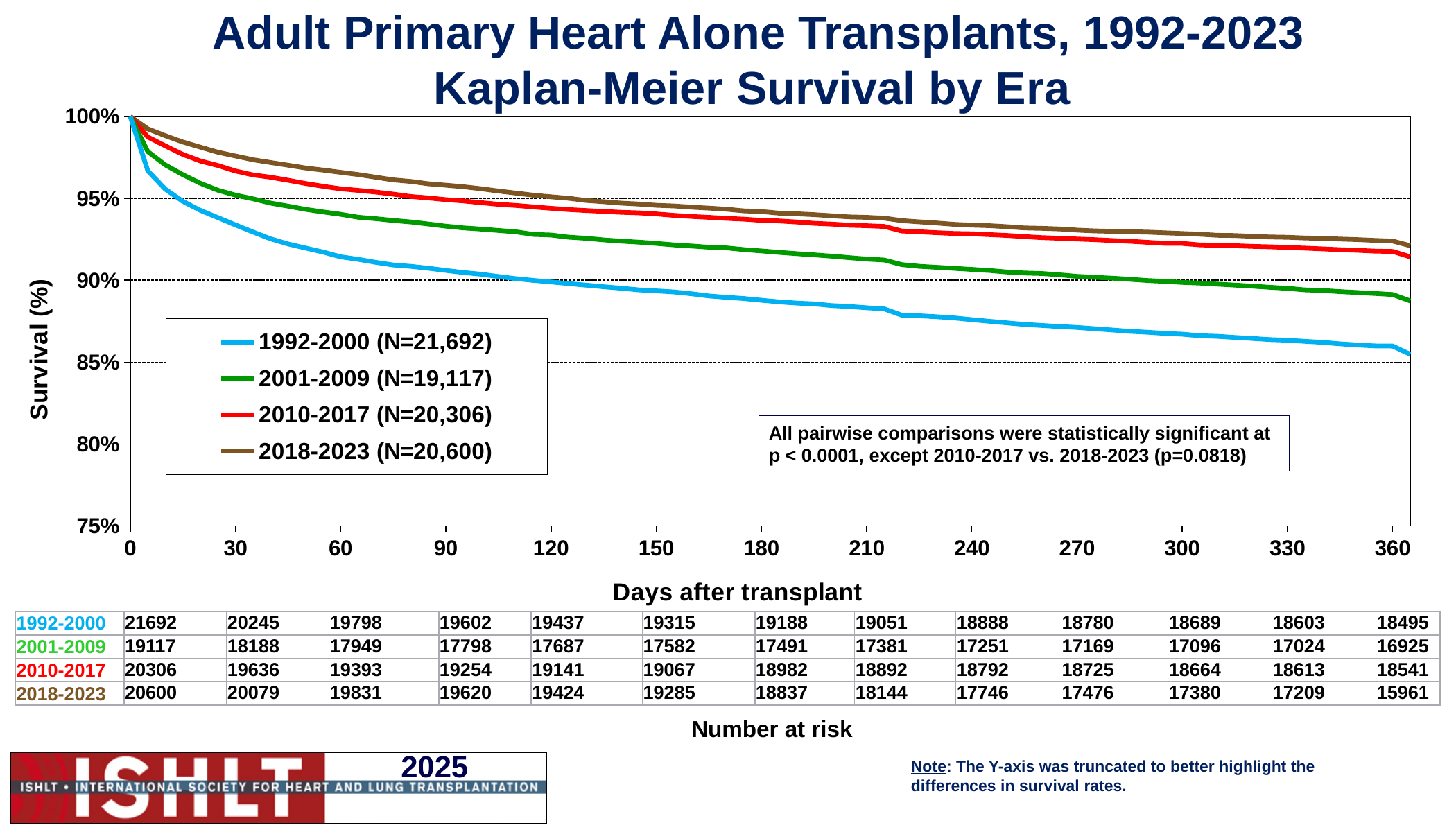
What p-value is given for the comparison of 2010-2017 vs. 2018-2023? 0.0818 In the number-at-risk table, what is the difference between the number at risk at day 0 for the 2018-2023 era and the 2001-2009 era? 1483 Is the survival for the 2018-2023 era at 360 days greater or less than 90%? greater In the number-at-risk table, how many patients were at risk for the 2018-2023 era at 360 days? 15961 According to the legend, what is N for the 1992-2000 era? 21,692 Do the survival curves rise or fall as days after transplant increase? fall Is the survival for the 1992-2000 era at 360 days greater or less than 90%? less What kind of chart is shown on the slide? line chart How many eras (series) does the legend list? 4 Which era has the highest survival curve across the whole period? 2018-2023 Is the survival for the 2010-2017 era at 180 days greater or less than 90%? greater Which era has the lowest survival curve across the whole period? 1992-2000